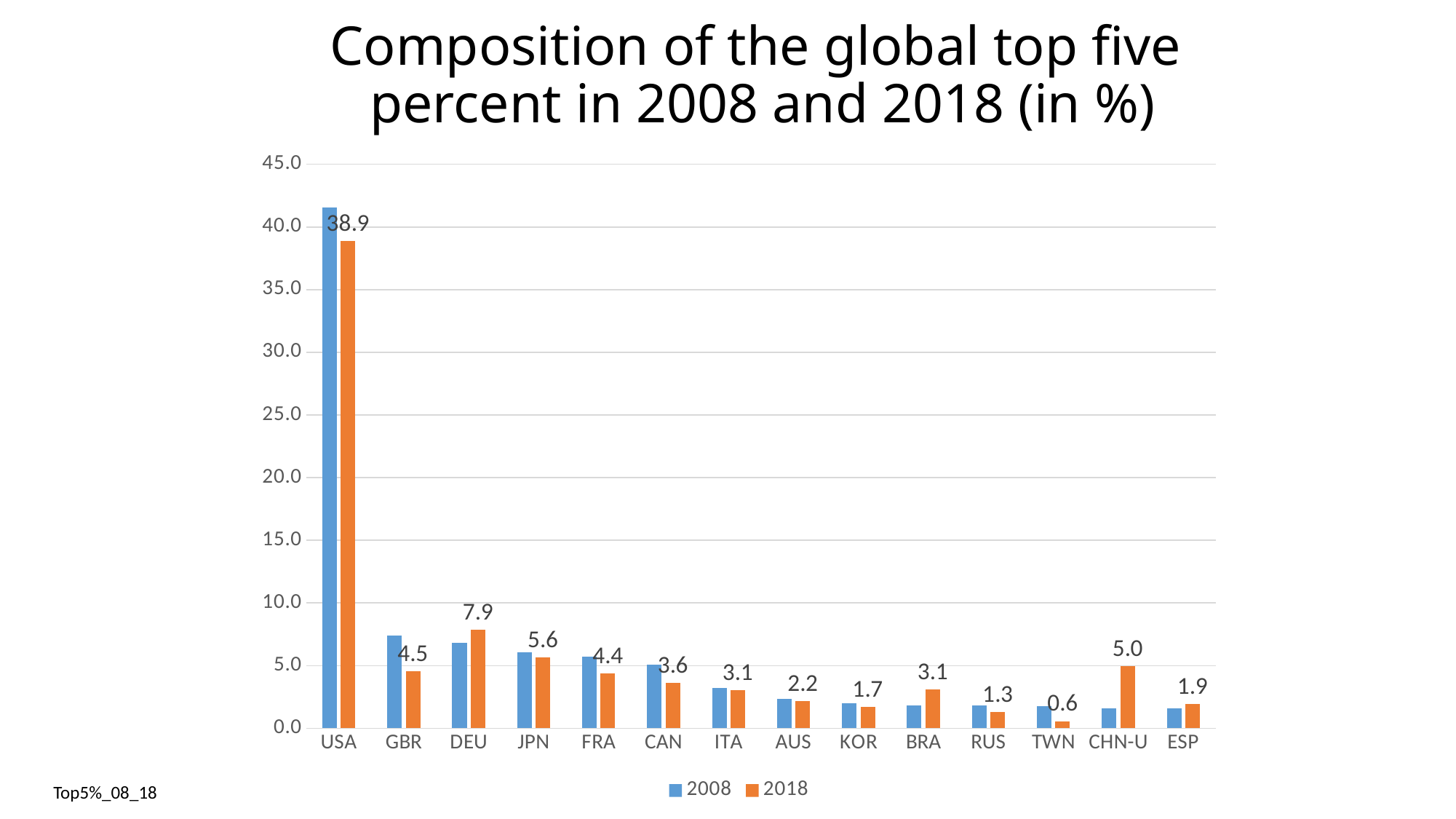
What is the difference between the 2018 values for DEU and GBR? 3.4 How many countries are shown on the x axis? 14 For DEU, which series is larger: 2008 or 2018? 2018 Is the 2008 value for USA greater or less than 40.0? greater What is the 2018 value for DEU? 7.9 Which country has the lowest 2018 value? TWN What is the 2018 value for CHN-U? 5.0 Which is larger for 2018: JPN or CHN-U? JPN What is the 2018 value for USA? 38.9 Which country has the highest 2018 value? USA What kind of chart is shown on the slide? bar chart How many series does the legend list? 2